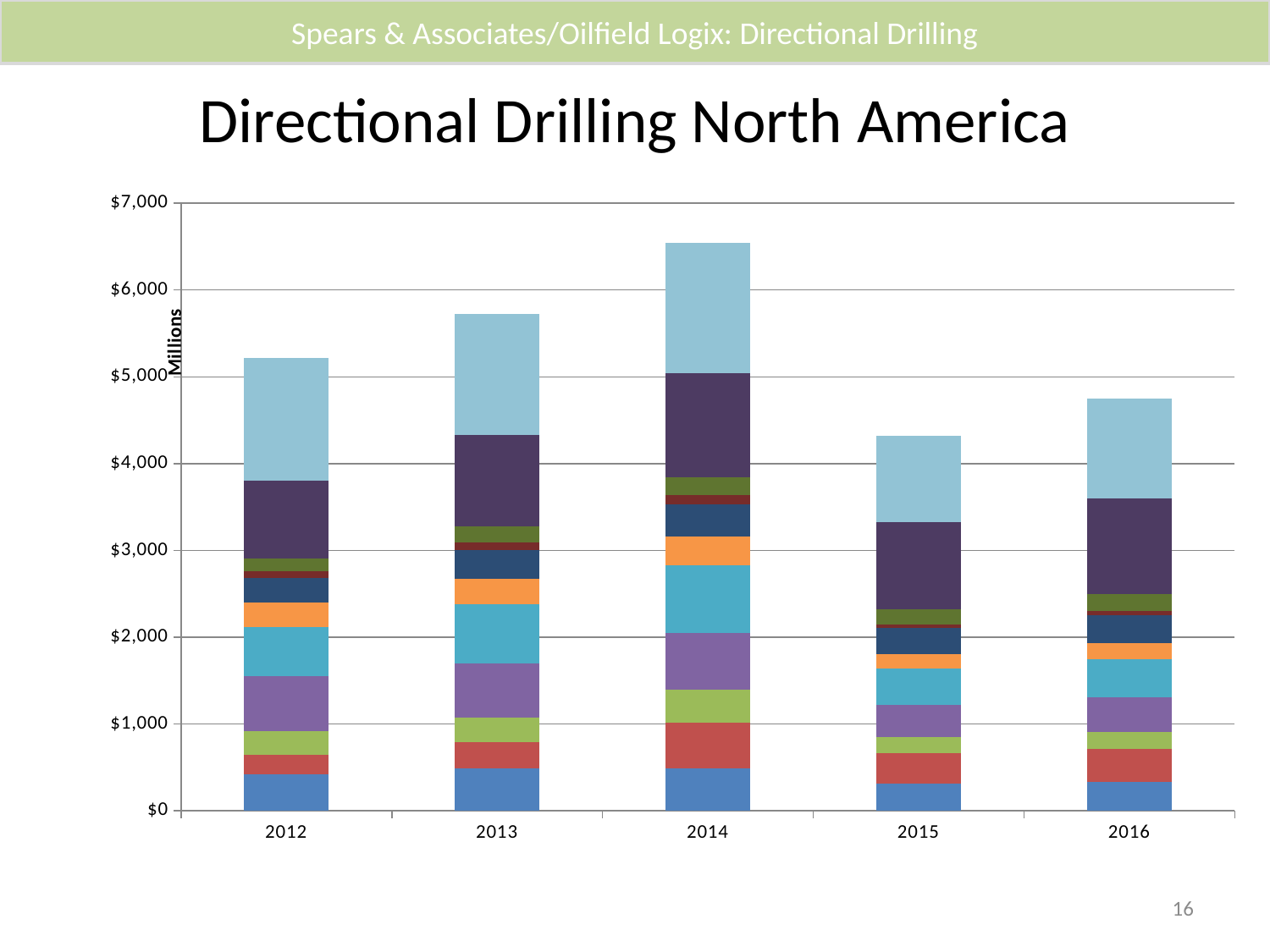
Which year has the tallest stacked bar? 2014 Which year has a larger total, 2013 or 2016? 2013 Does the total rise or fall from 2014 to 2015? fall Is the total for 2012 greater or less than $5,000? greater What is the title of the chart? Directional Drilling North America Is the total for 2015 greater or less than $5,000? less Is the total for 2016 greater or less than $5,000? less How many years are shown on the x axis of the chart? 5 Which year has the shortest stacked bar? 2015 What kind of chart is shown on the slide? Stacked bar chart What is the label on the vertical axis of the chart? Millions